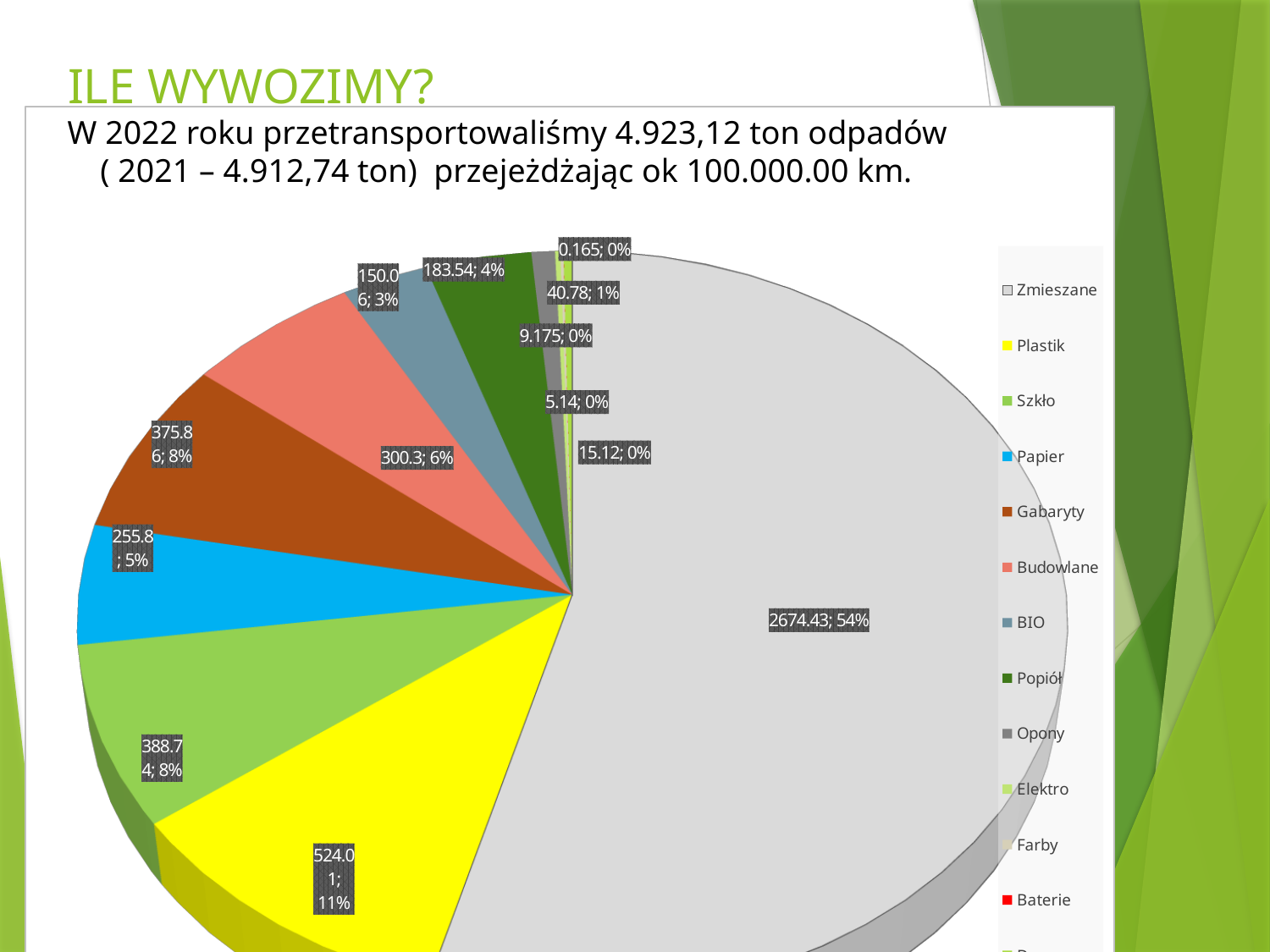
What is the value shown for the Papier slice? 255.8 What is the value shown for the Szkło slice? 388.74 What is the value shown for the Zmieszane slice? 2674.43 What is the value shown for the Plastik slice? 524.01 What percentage share does the Plastik slice have? 11% What is the difference between the Zmieszane value and the Plastik value? 2150.42 What type of chart is shown on the slide? pie chart What is the value shown for the Gabaryty slice? 375.86 Which category has the largest slice of the pie? Zmieszane What percentage share does the Zmieszane slice have? 54% Which is larger, the Plastik slice or the Szkło slice? Plastik What is the value shown for the Budowlane slice? 300.3